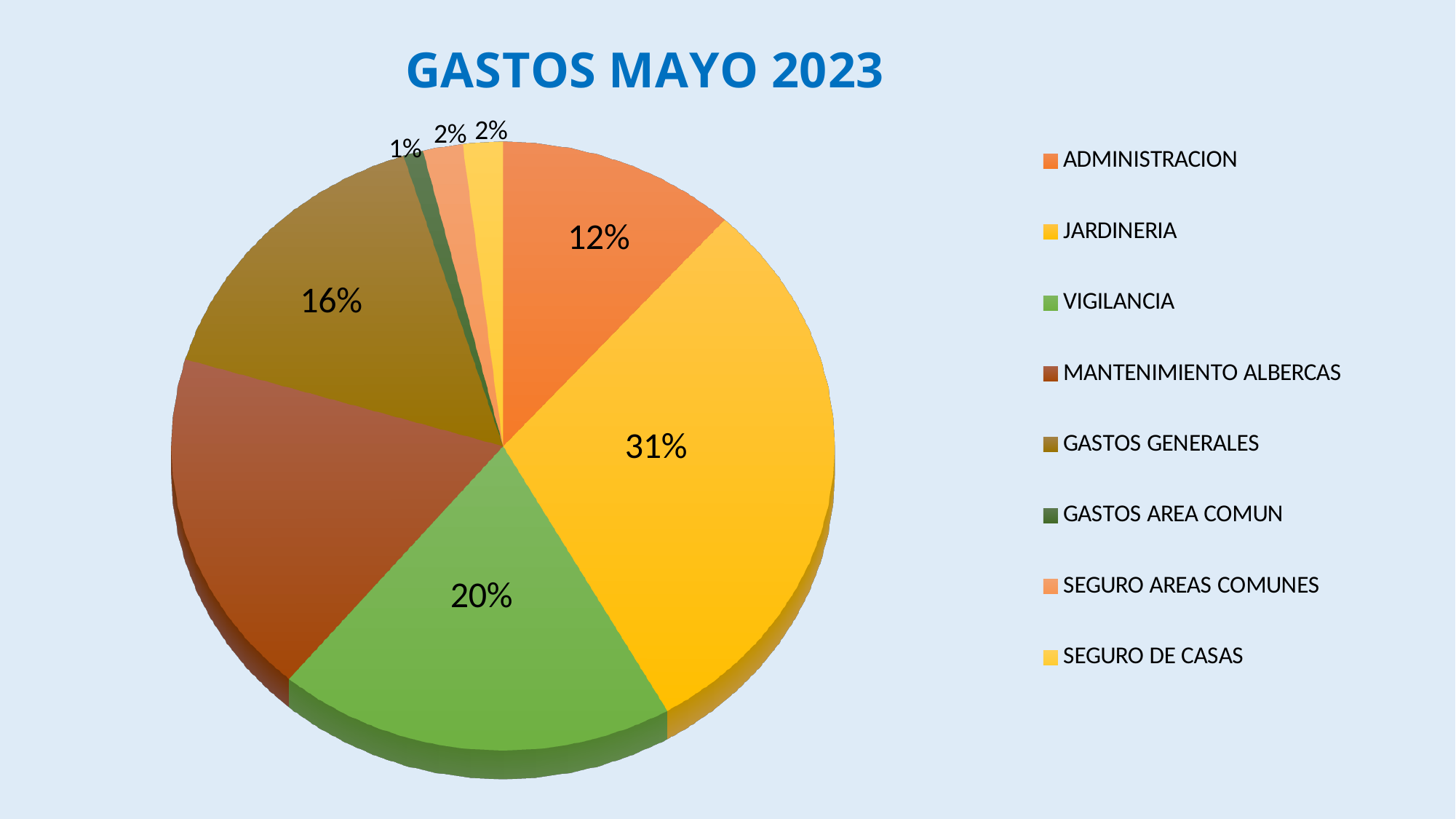
What is the title of the chart? GASTOS MAYO 2023 What percentage of the pie does GASTOS GENERALES represent? 16% What percentage of the pie does VIGILANCIA represent? 20% Which is larger, the share for GASTOS GENERALES or the share for ADMINISTRACION? GASTOS GENERALES What percentage of the pie does JARDINERIA represent? 31% What is the difference in percentage points between JARDINERIA and VIGILANCIA? 11 How many categories does the legend list? 8 What type of chart is shown on the slide? Pie chart What percentage of the pie does GASTOS AREA COMUN represent? 1% Which category has the smallest share of the pie? GASTOS AREA COMUN Which category has the largest share of the pie? JARDINERIA What percentage of the pie does ADMINISTRACION represent? 12%